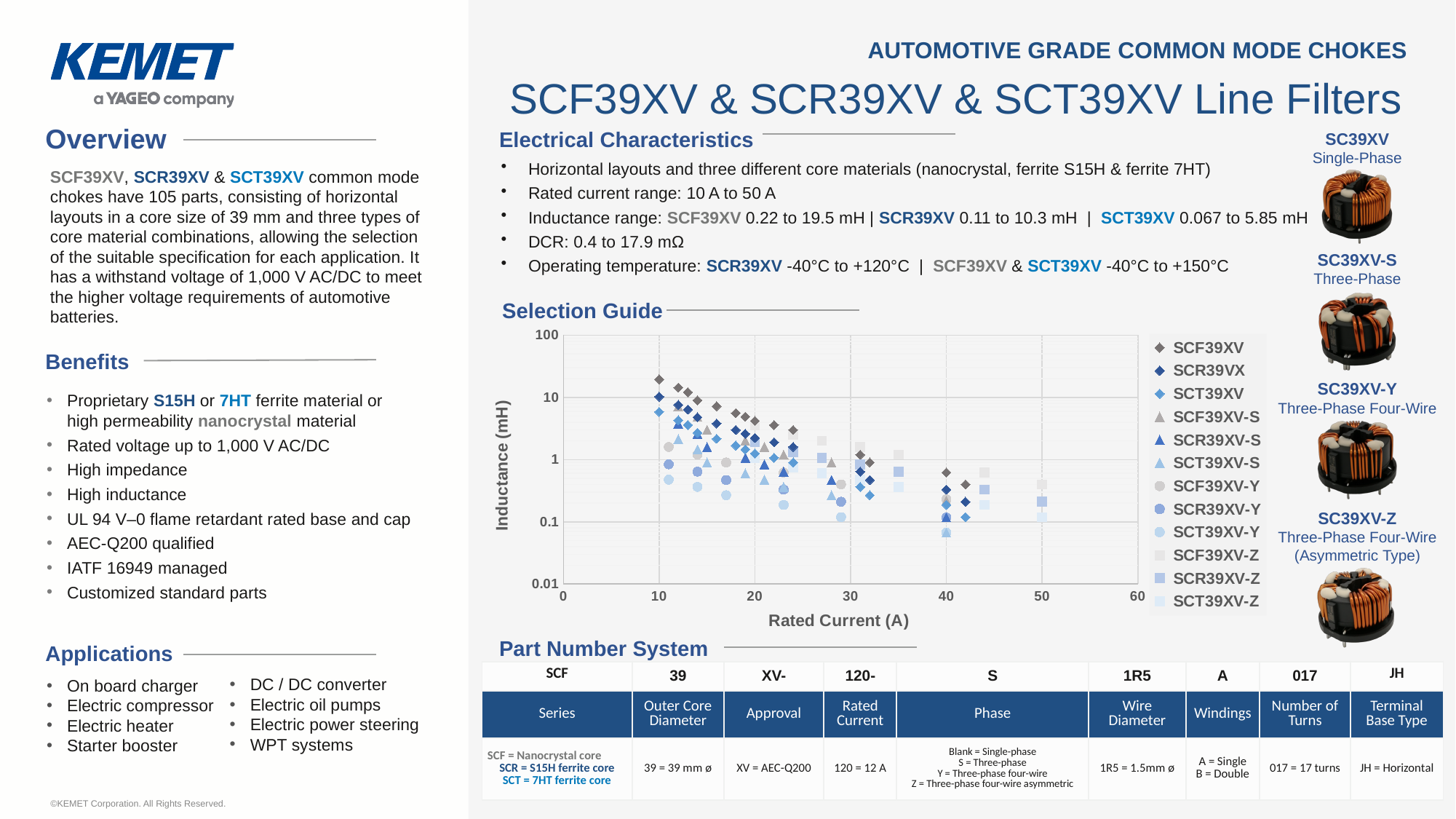
What kind of chart is the Selection Guide chart? scatter chart In the Selection Guide chart, is the inductance of the SCT39XV point at 10 A greater or less than 1 mH? greater What is the highest value shown on the y axis of the Selection Guide chart? 100 In the Selection Guide chart, which series has the higher inductance at 10 A, SCF39XV or SCT39XV? SCF39XV In the Selection Guide chart, is the inductance of the SCR39XV-Z point at 50 A greater or less than 1 mH? less What is the title of the x axis of the Selection Guide chart? Rated Current (A) What is the title of the y axis of the Selection Guide chart? Inductance (mH) In the Selection Guide chart, is the inductance of the SCT39XV-Y point at 40 A greater or less than 0.1 mH? less How many series does the legend of the Selection Guide chart list? 12 In the Selection Guide chart, does inductance generally rise or fall as rated current increases? fall